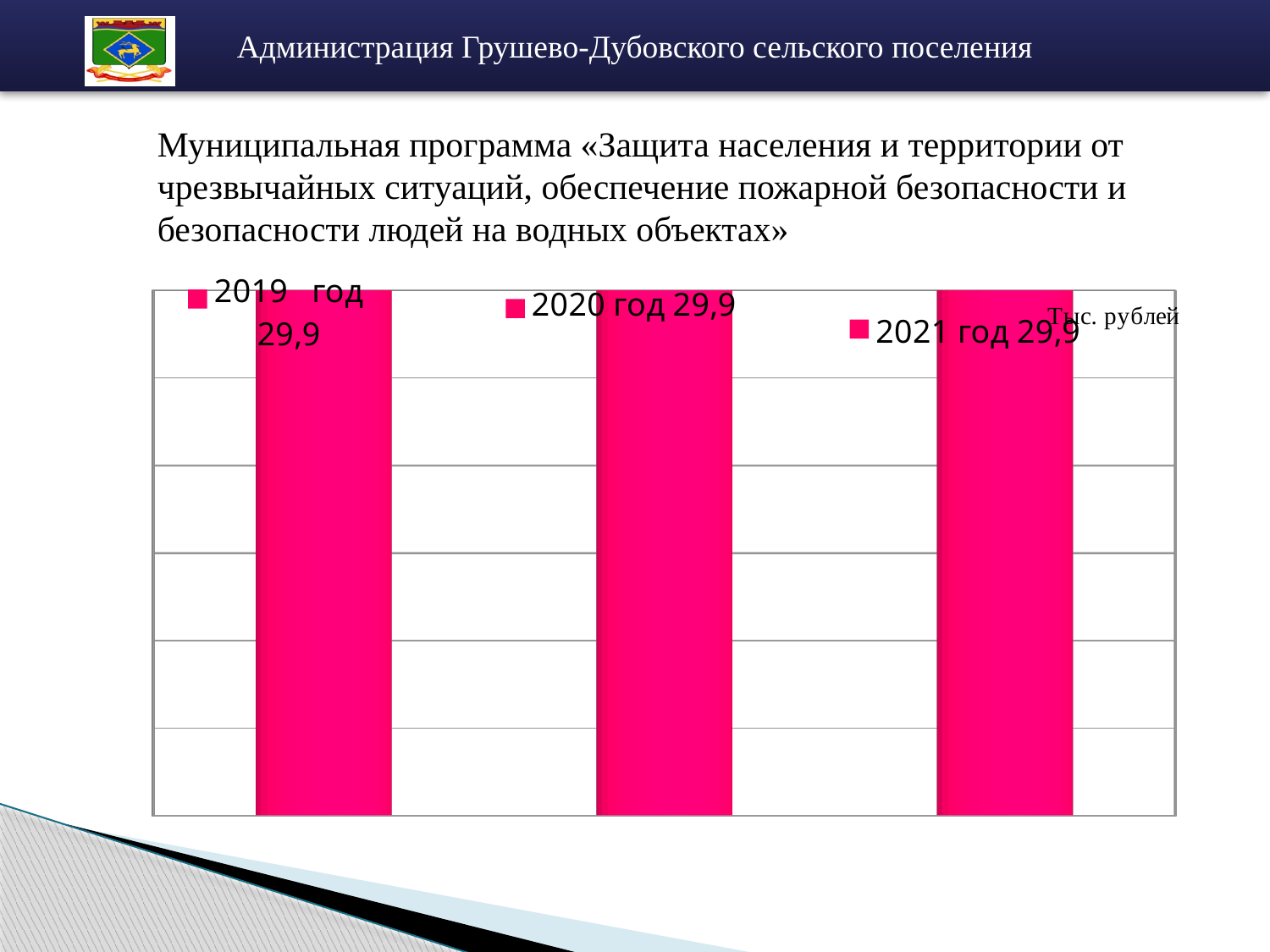
What is the difference between the values for 2021 год and 2019 год? 0 What unit is indicated for the values on the chart? Тыс. рублей Do the values rise, fall, or stay the same from 2019 год to 2021 год? stay the same What kind of chart is shown on the slide? bar chart What is the value for 2020 год? 29,9 What colour are the bars on the chart? pink (magenta) How many bars are plotted on the chart? 3 What is the value for 2021 год? 29,9 Is the value for 2020 год larger than, smaller than, or equal to the value for 2019 год? equal What is the value for 2019 год? 29,9